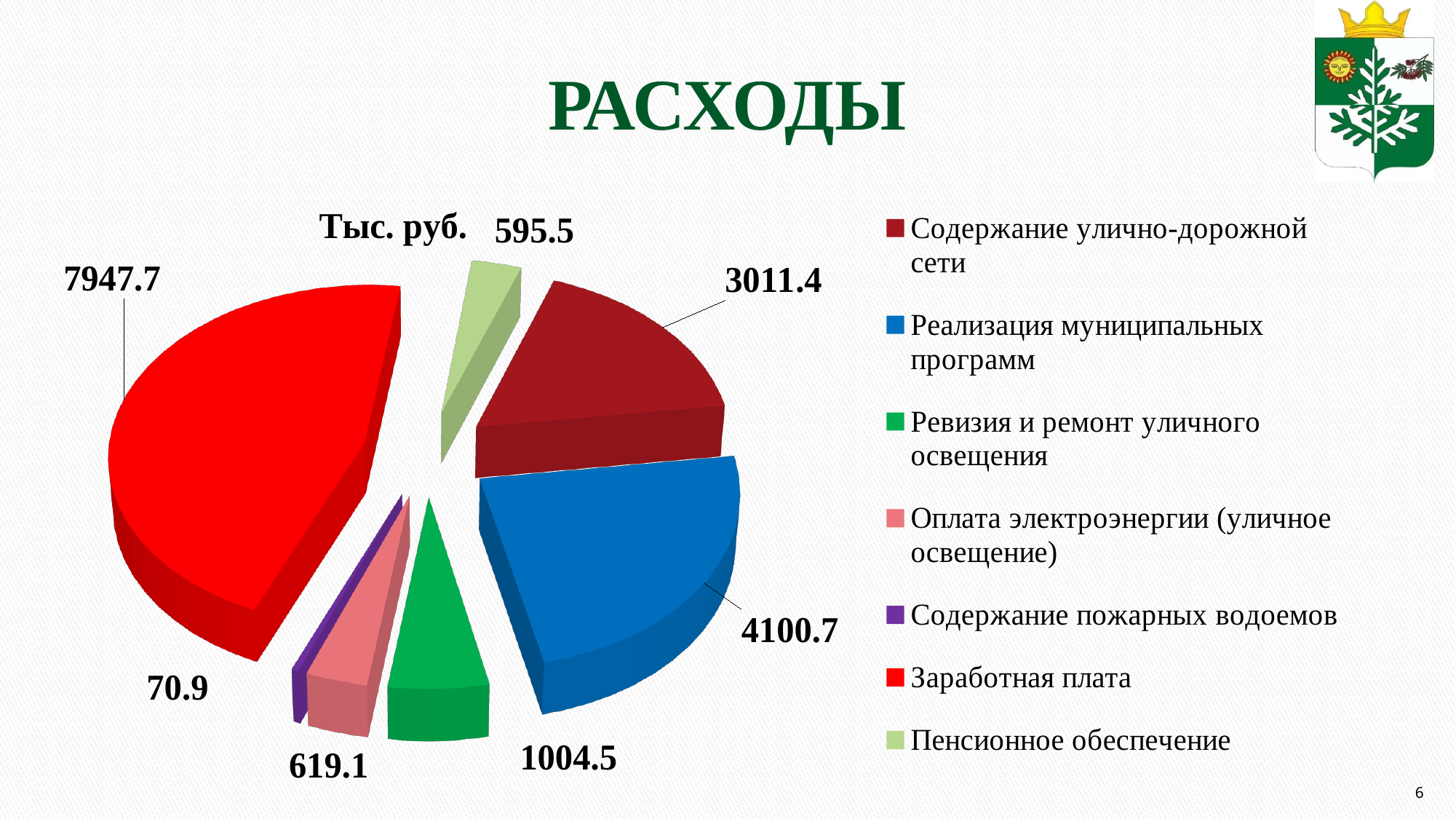
What type of chart is shown on the slide? Pie chart Which is larger: Ревизия и ремонт уличного освещения or Оплата электроэнергии (уличное освещение)? Ревизия и ремонт уличного освещения How many categories does the pie chart have? 7 What is the value for Заработная плата? 7947.7 What is the value for Пенсионное обеспечение? 595.5 Which category has the smallest value? Содержание пожарных водоемов What is the difference between Заработная плата and Реализация муниципальных программ? 3847.0 What is the value for Содержание пожарных водоемов? 70.9 What is the value for Реализация муниципальных программ? 4100.7 What unit is given in the chart title? Тыс. руб. What is the difference between Реализация муниципальных программ and Содержание улично-дорожной сети? 1089.3 Which category has the largest value? Заработная плата